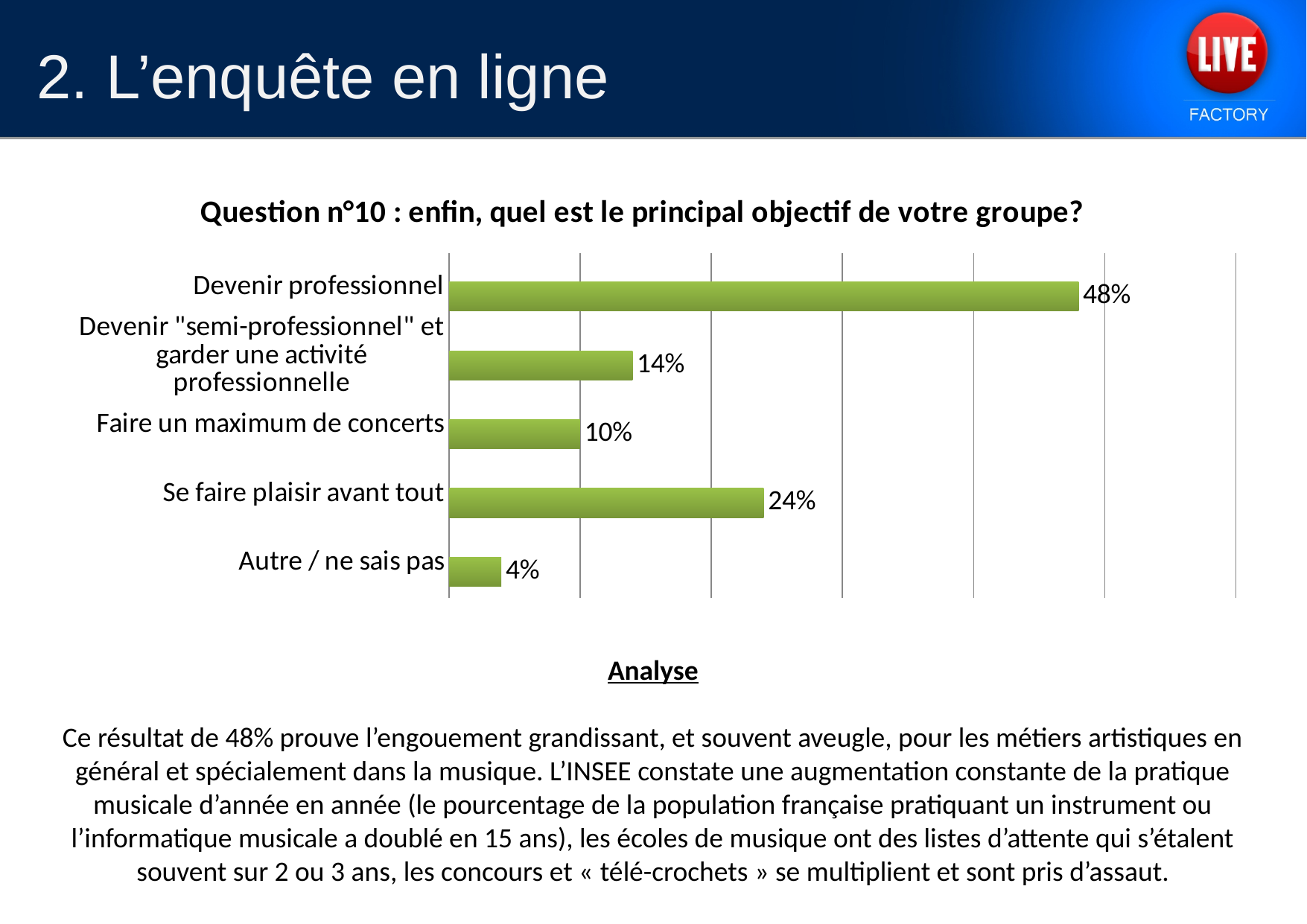
How many categories are shown in the chart? 5 Which is larger: "Devenir "semi-professionnel" et garder une activité professionnelle" or "Faire un maximum de concerts"? Devenir "semi-professionnel" et garder une activité professionnelle Which category has the lowest value? Autre / ne sais pas What is the value for "Autre / ne sais pas"? 4% Which category has the highest value? Devenir professionnel What is the value for "Se faire plaisir avant tout"? 24% What kind of chart is shown on the slide? Bar chart What is the value for "Faire un maximum de concerts"? 10% What colour are the bars in the chart? Green What is the title of the chart? Question n°10 : enfin, quel est le principal objectif de votre groupe? What is the difference between "Devenir professionnel" and "Se faire plaisir avant tout"? 24% What is the value for "Devenir professionnel"? 48%